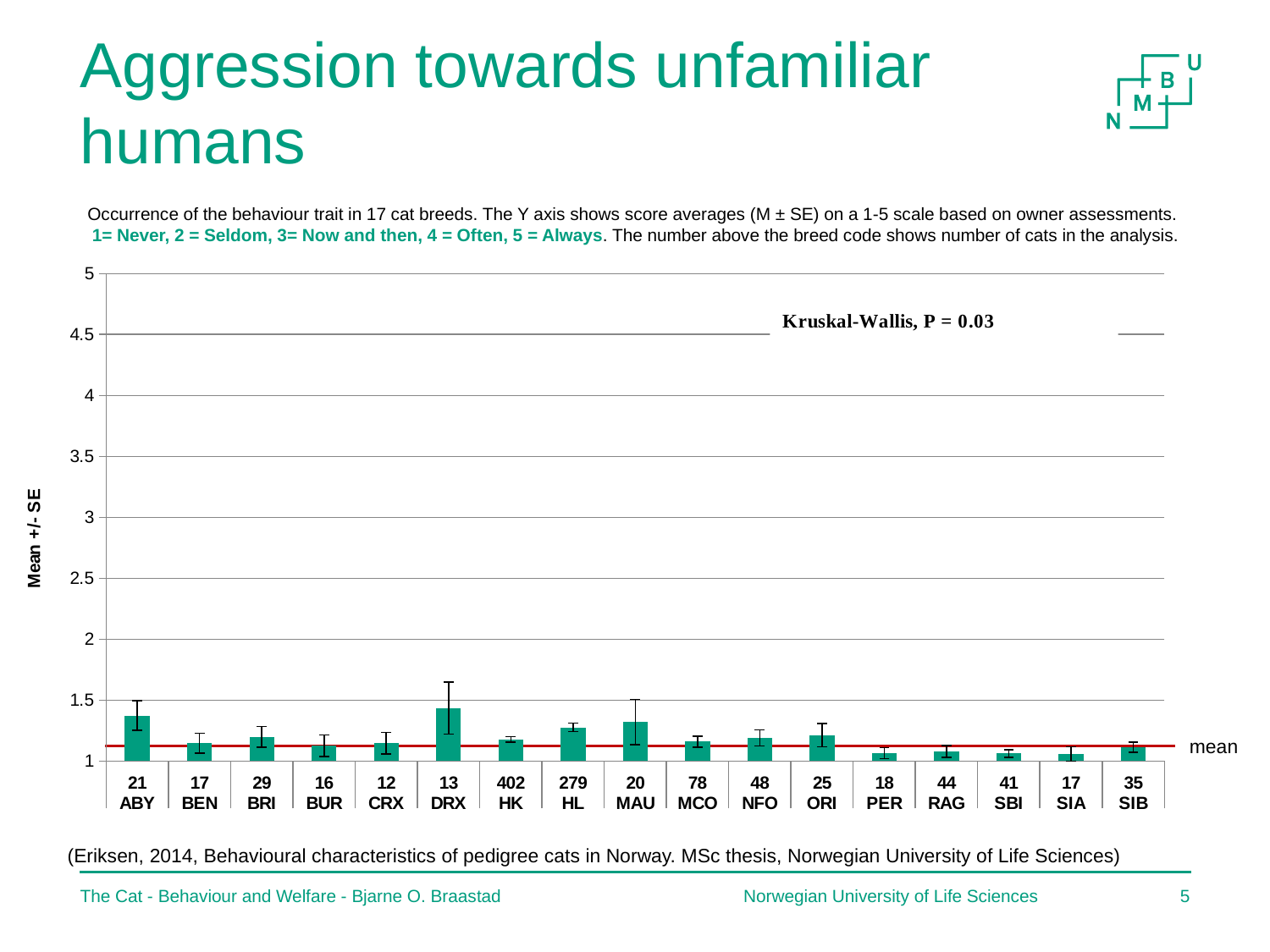
Which bar is taller, DRX or PER? DRX Which breed has the highest bar in the chart? DRX What is the label of the y axis of the chart? Mean +/- SE Which bar is taller, HL or SIA? HL How many cats were included in the analysis for the HK breed, according to the number above the breed code? 402 What kind of chart is shown on the slide? Bar chart Which bar is taller, ABY or BEN? ABY Is the value for DRX greater or less than 1.5? less How many cat breeds are shown on the x axis of the chart? 17 How many cats were included in the analysis for the HL breed, according to the number above the breed code? 279 What P value is reported for the Kruskal-Wallis test on the chart? 0.03 Is the value for ABY greater or less than 2? less